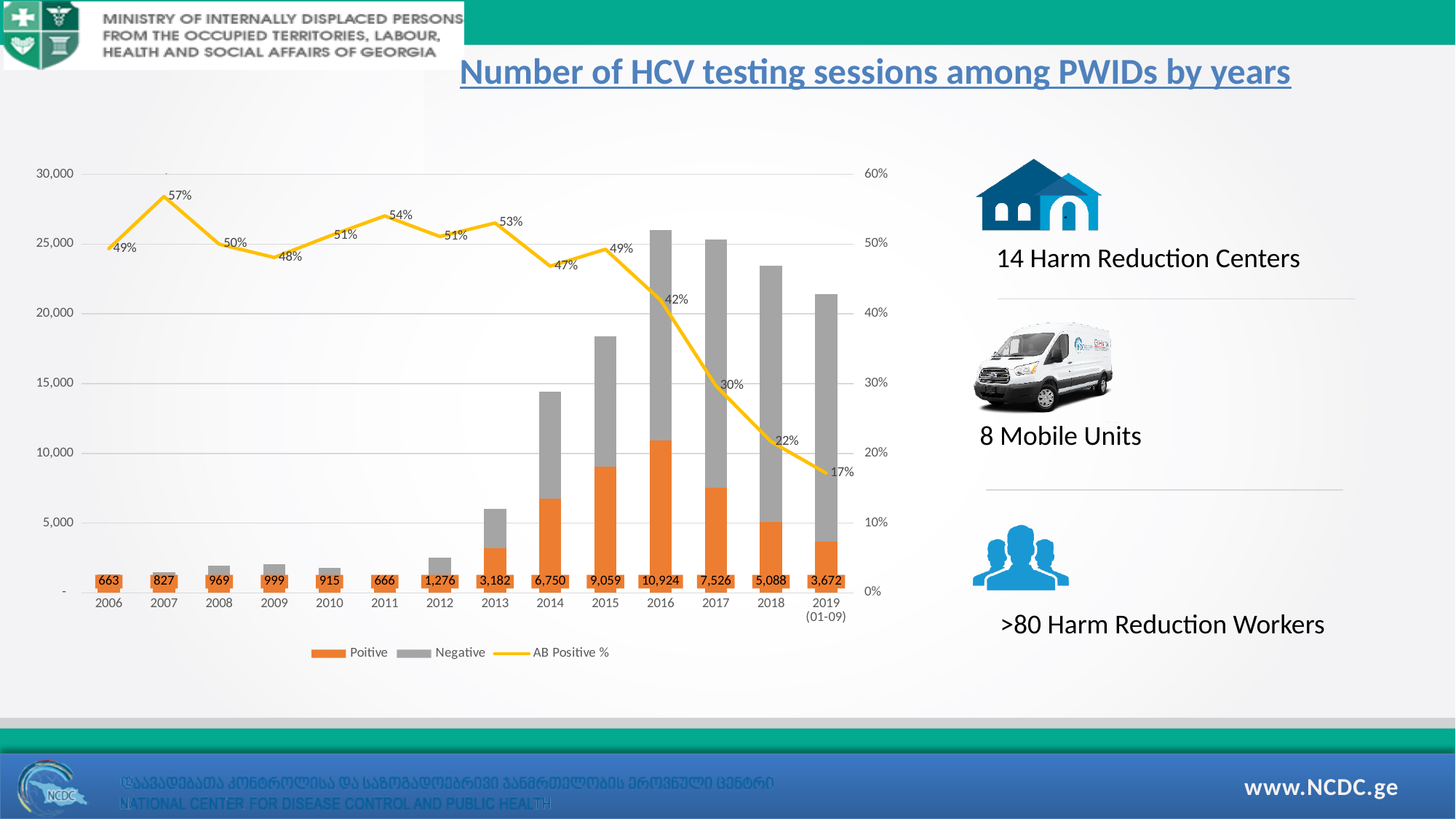
Which year has the highest Positive value? 2016 How many years are shown on the x axis? 14 How many series does the legend list? 3 What is the AB Positive % for 2007? 57% What is the Positive value for 2019 (01-09)? 3,672 Is the total height of the stacked bar for 2016 greater or less than 25,000? greater Which year has the lowest AB Positive %? 2019 (01-09) What kind of chart is this? Stacked bar chart with a line What is the difference between the Positive values for 2016 and 2017? 3,398 Which is larger, the Positive value for 2014 or for 2018? 2014 Does the AB Positive % line rise or fall from 2015 to 2019 (01-09)? fall What is the Positive value for 2016? 10,924